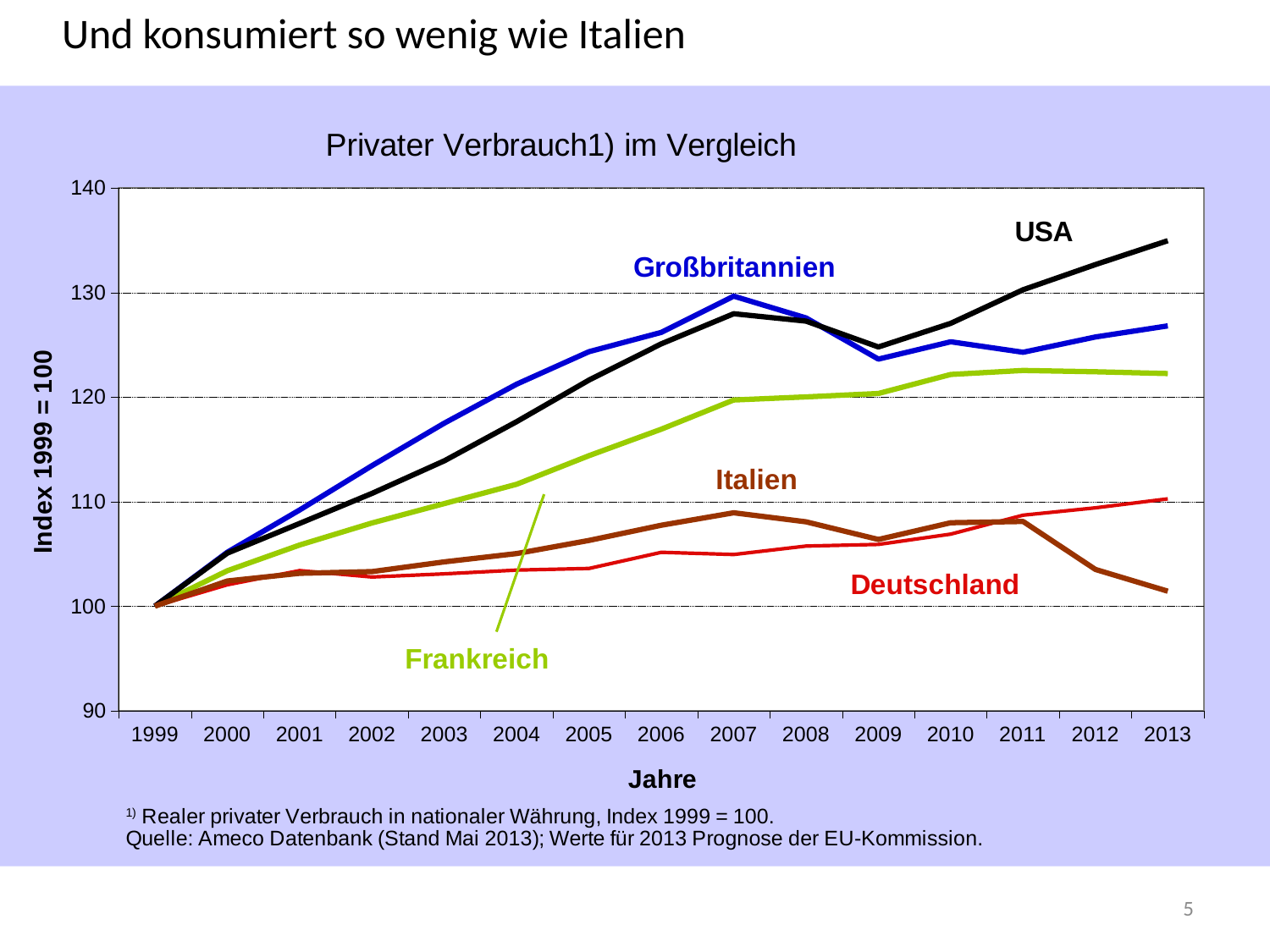
Which is larger in 2013, the value for USA or the value for Großbritannien? USA How many countries are plotted as lines in the chart? 5 Is the value for USA in 2013 greater or less than 130? greater Is the value for Frankreich in 2013 greater or less than 120? greater Is the value for Deutschland in 2005 greater or less than 110? less What is the index value for all countries in 1999? 100 How many years are shown on the x axis? 15 Which country has the lowest index value in 2013? Italien What is the title of the chart? Privater Verbrauch1) im Vergleich Does the line for Italien rise or fall between 2011 and 2013? fall What kind of chart is shown on the slide? line chart Which country has the highest index value in 2013? USA